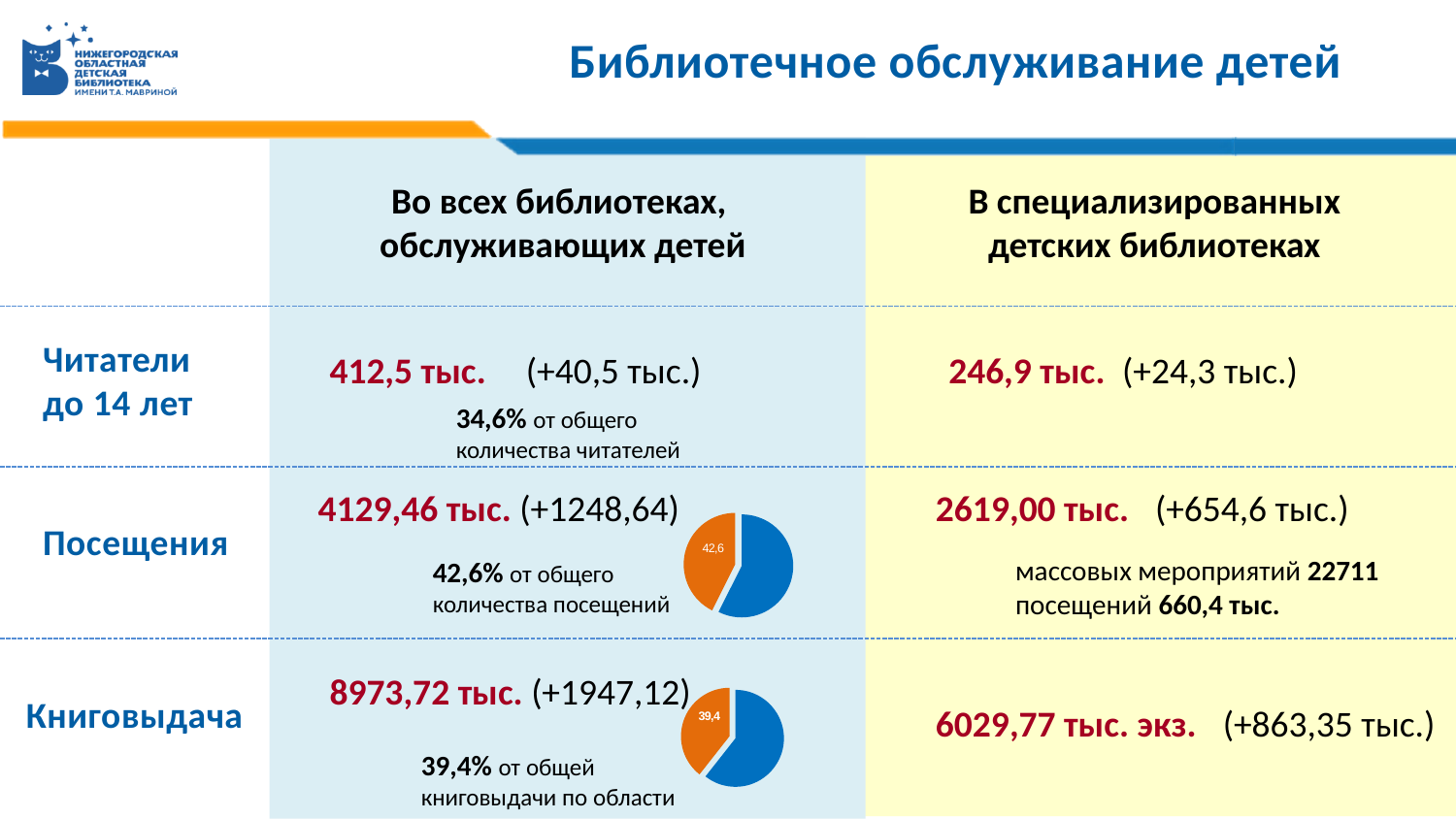
What share of the pie chart next to the "Посещения" row does the orange slice represent? 42,6% What kind of chart is shown next to the "Посещения" row? pie chart In the pie chart next to the "Книговыдача" row, what value is printed on the orange slice? 39,4 Is the orange slice in the pie chart next to the "Книговыдача" row greater or less than 50% of the pie? less In the pie chart next to the "Книговыдача" row, which slice is larger, the orange one or the blue one? the blue one What share of the pie chart next to the "Книговыдача" row does the orange slice represent? 39,4% What colour is the labelled slice in the pie chart next to the "Посещения" row? orange How many slices does the pie chart next to the "Посещения" row have? 2 In the pie chart next to the "Посещения" row, what value is printed on the orange slice? 42,6 How many slices does the pie chart next to the "Книговыдача" row have? 2 In the pie chart next to the "Посещения" row, which slice is larger, the orange one or the blue one? the blue one What kind of chart is shown next to the "Книговыдача" row? pie chart